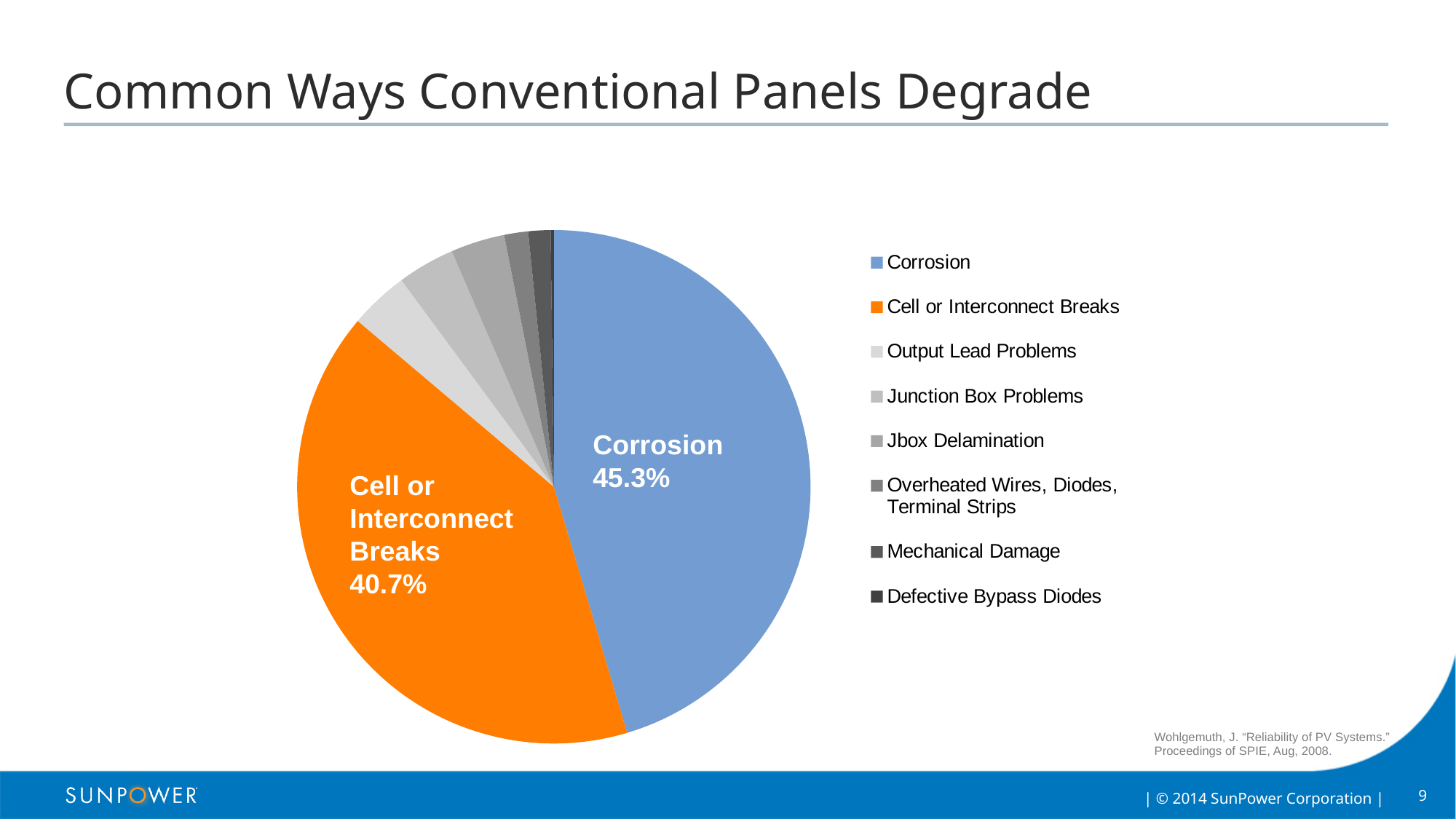
What percentage of the pie is attributed to Corrosion? 45.3% How many categories does the pie chart show? 8 What is the title of the chart on the slide? Common Ways Conventional Panels Degrade Which category has the largest share of the pie? Corrosion Which is larger, the share for Corrosion or the share for Cell or Interconnect Breaks? Corrosion What is the difference between the Corrosion share and the Cell or Interconnect Breaks share? 4.6% What share of the pie does the Corrosion slice represent? 45.3% What percentage of the pie is attributed to Cell or Interconnect Breaks? 40.7% How many entries does the legend list? 8 What colour is the Cell or Interconnect Breaks slice? Orange What type of chart is shown on the slide? Pie chart Which is larger, the share for Output Lead Problems or the share for Corrosion? Corrosion